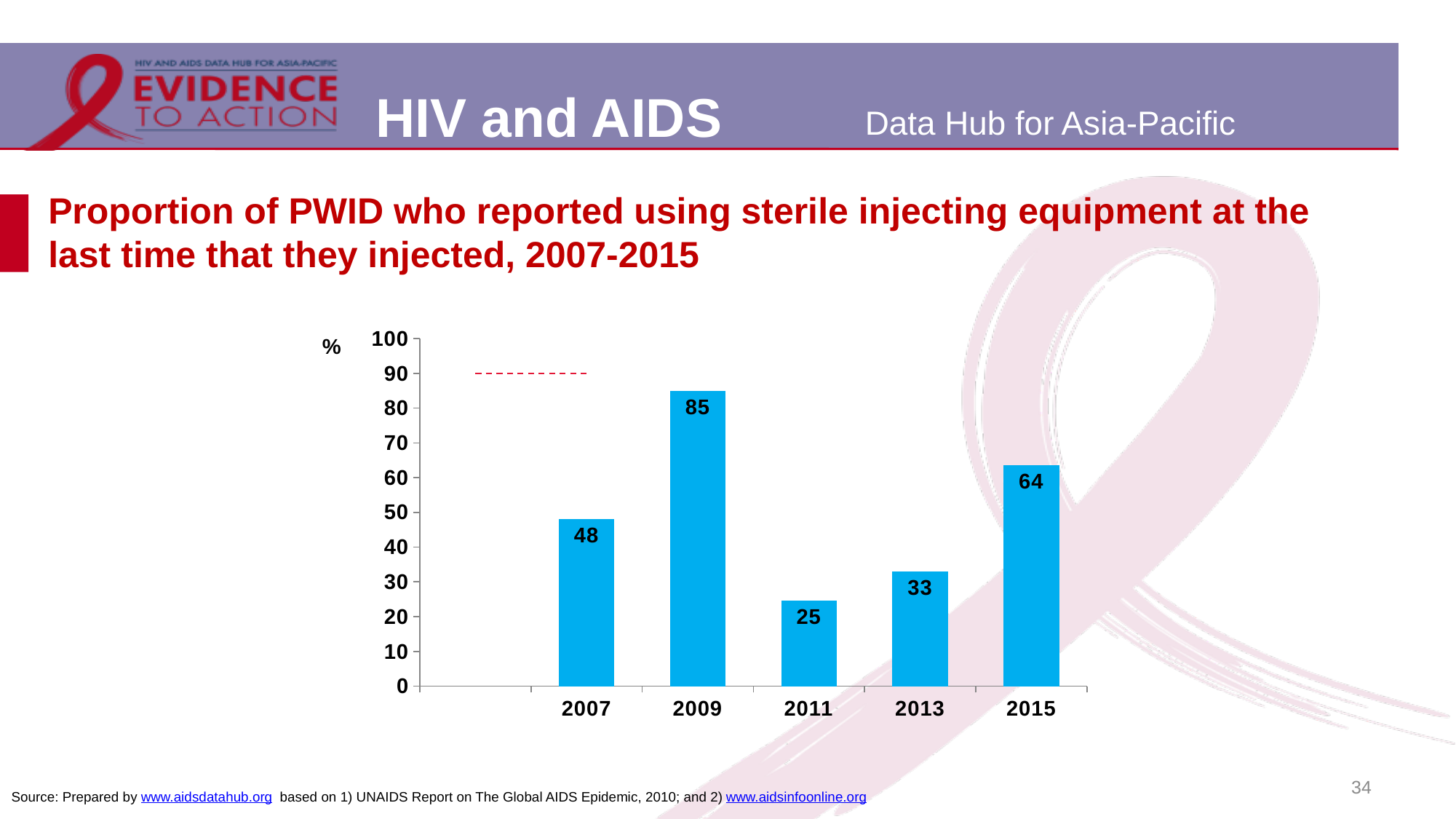
What is the value for 2015? 64 What kind of chart is shown on the slide? bar chart Is the value for 2015 greater or less than 50? greater What is the value for 2011? 25 Which year has the highest value? 2009 What is the value for 2009? 85 What is the difference between the values for 2009 and 2007? 37 Which is larger, the value for 2007 or the value for 2013? 2007 Which year has the lowest value? 2011 What unit is shown on the y axis label? % What is the difference between the values for 2015 and 2013? 31 How many years are shown on the x axis? 5